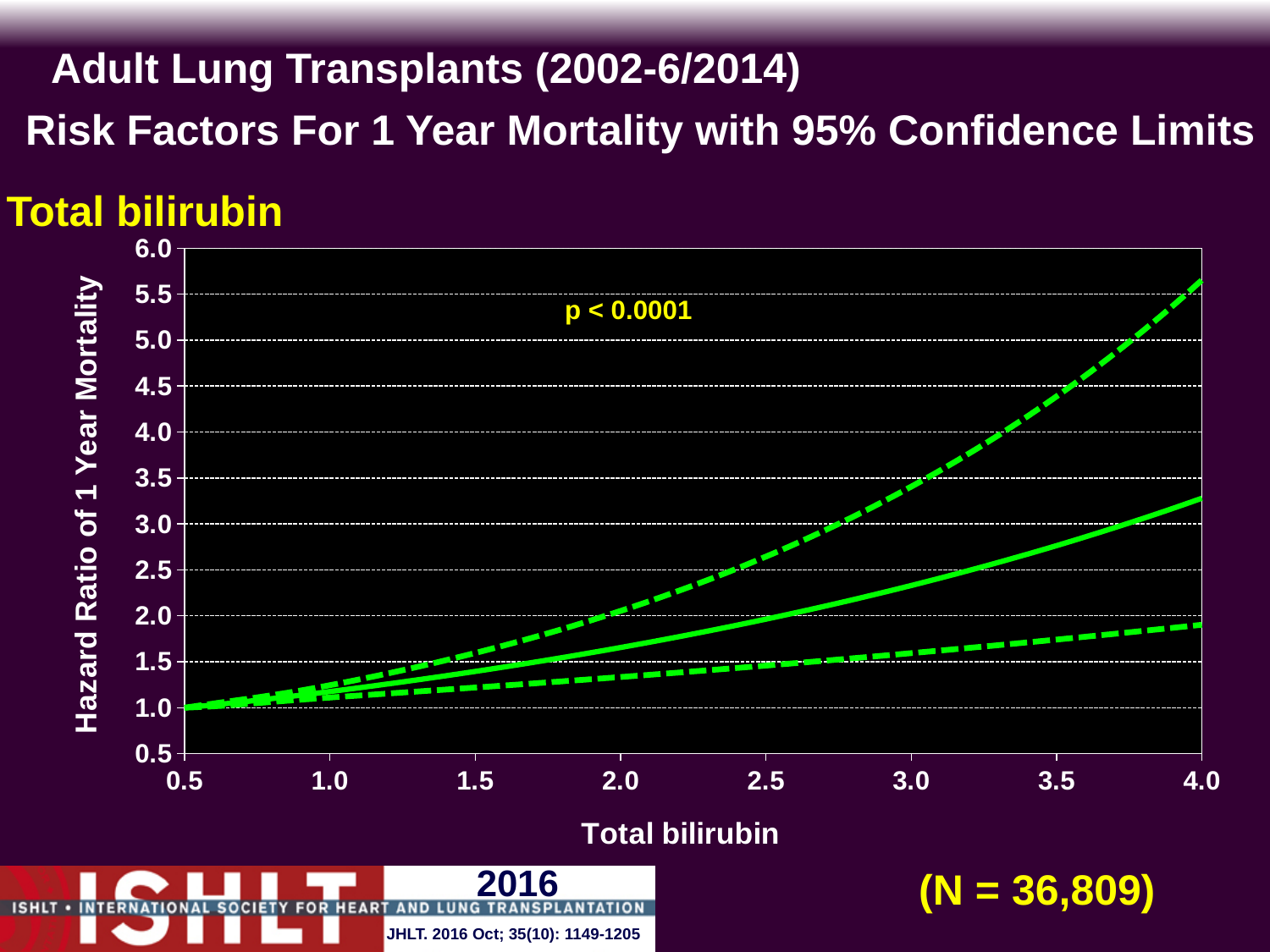
Is the value of the lower dashed line at a total bilirubin of 4.0 greater or less than 2.5? less Is the value of the upper dashed line at a total bilirubin of 3.0 greater or less than 3.0? greater Does the hazard ratio of 1 year mortality rise or fall as total bilirubin increases? rise How many lines are plotted on the chart? 3 Is the value of the upper dashed line at a total bilirubin of 4.0 greater or less than 5.0? greater At a total bilirubin of 4.0, which is larger: the solid line or the lower dashed line? the solid line What kind of chart is shown on the slide? line chart What is the hazard ratio of the solid line at a total bilirubin of 0.5? 1.0 What sample size (N) is shown on the slide? N = 36,809 What p-value is printed on the chart? p < 0.0001